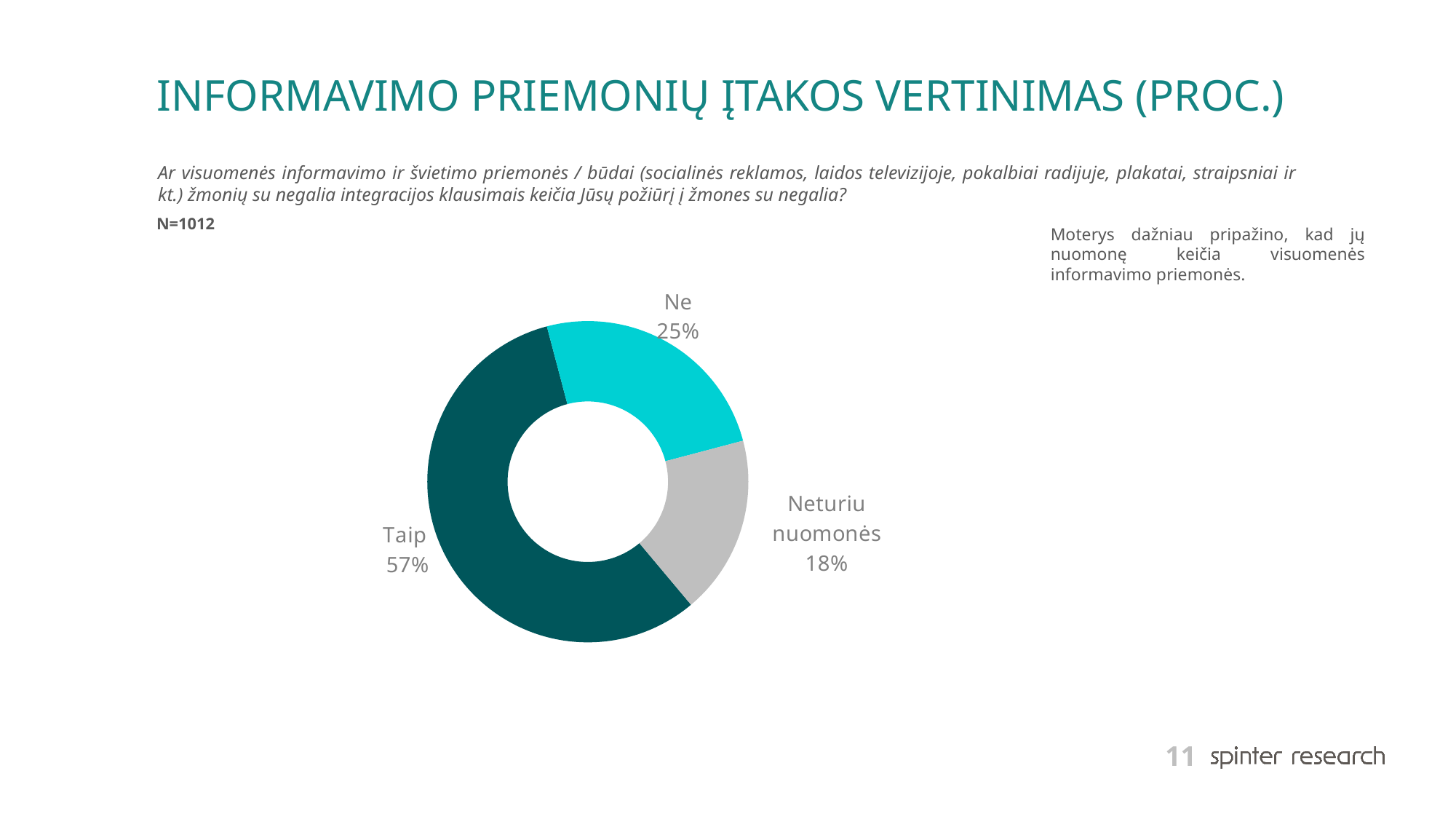
What percentage of respondents answered "Taip"? 57% What is the sample size (N) stated on the slide? N=1012 What colour is the "Taip" slice of the chart? Dark teal How many categories are shown in the chart? 3 What percentage of respondents answered "Ne"? 25% Which response has the largest share of the pie? Taip What percentage of respondents answered "Neturiu nuomonės"? 18% Which response has the smallest share of the pie? Neturiu nuomonės What kind of chart is shown on the slide? Pie chart (doughnut) What is the difference in percentage points between "Ne" and "Neturiu nuomonės"? 7 Which is larger, the share for "Ne" or the share for "Neturiu nuomonės"? Ne What is the difference in percentage points between "Taip" and "Ne"? 32